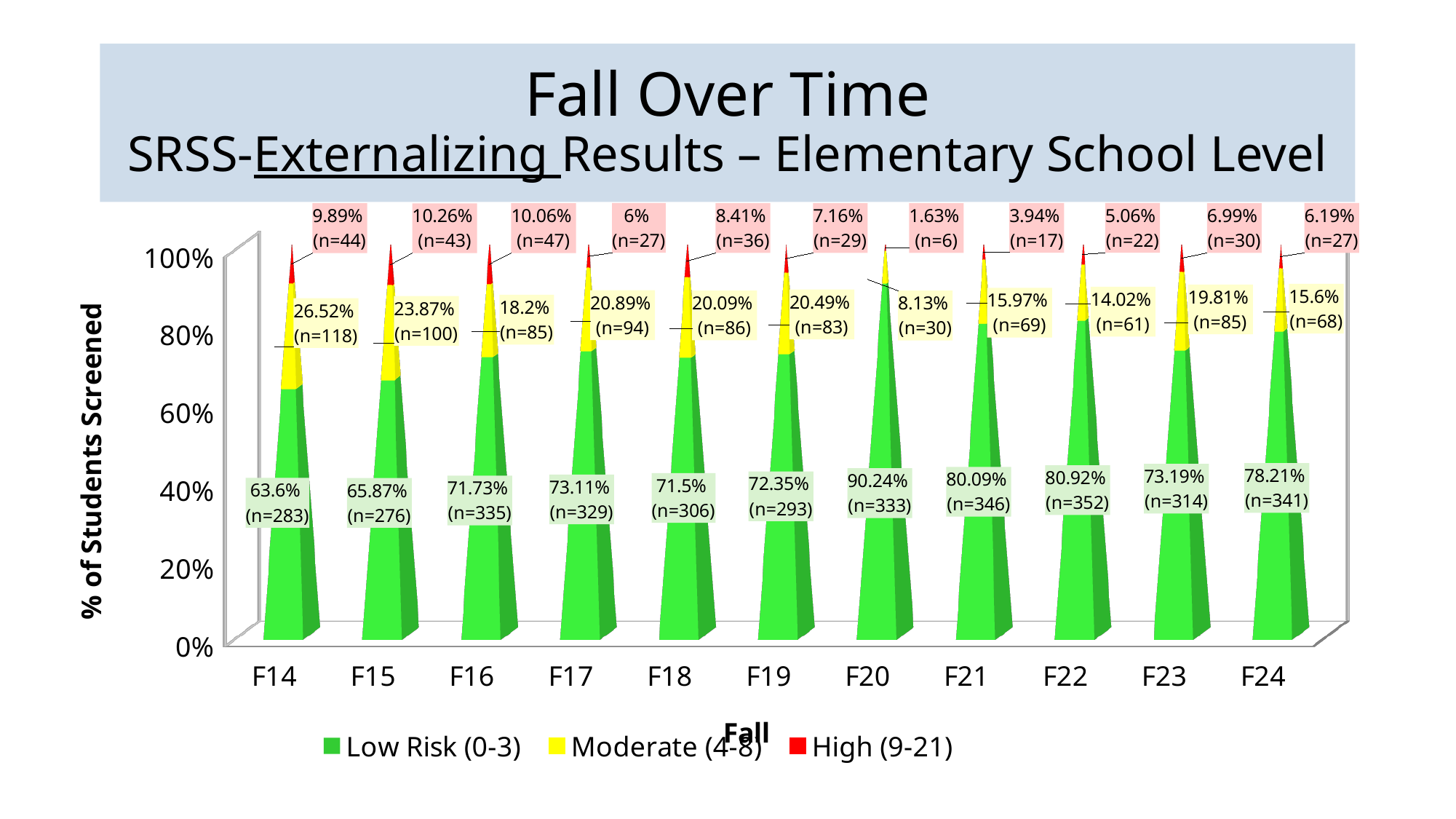
Which is larger, the High (9-21) percentage for F15 or for F16? F15 Which fall term has the highest Moderate (4-8) percentage? F14 What is the High (9-21) percentage for F20? 1.63% Which fall term has the lowest High (9-21) percentage? F20 How many series does the legend list? 3 How many students were in the Low Risk (0-3) group in F22 (the n value)? n=352 Which fall term has the highest Low Risk (0-3) percentage? F20 What is the Moderate (4-8) percentage for F17? 20.89% What is the Low Risk (0-3) percentage for F14? 63.6% What is the label of the y axis? % of Students Screened How many fall terms are shown on the x axis? 11 What is the difference between the Low Risk (0-3) percentages for F22 and F21? 0.83%